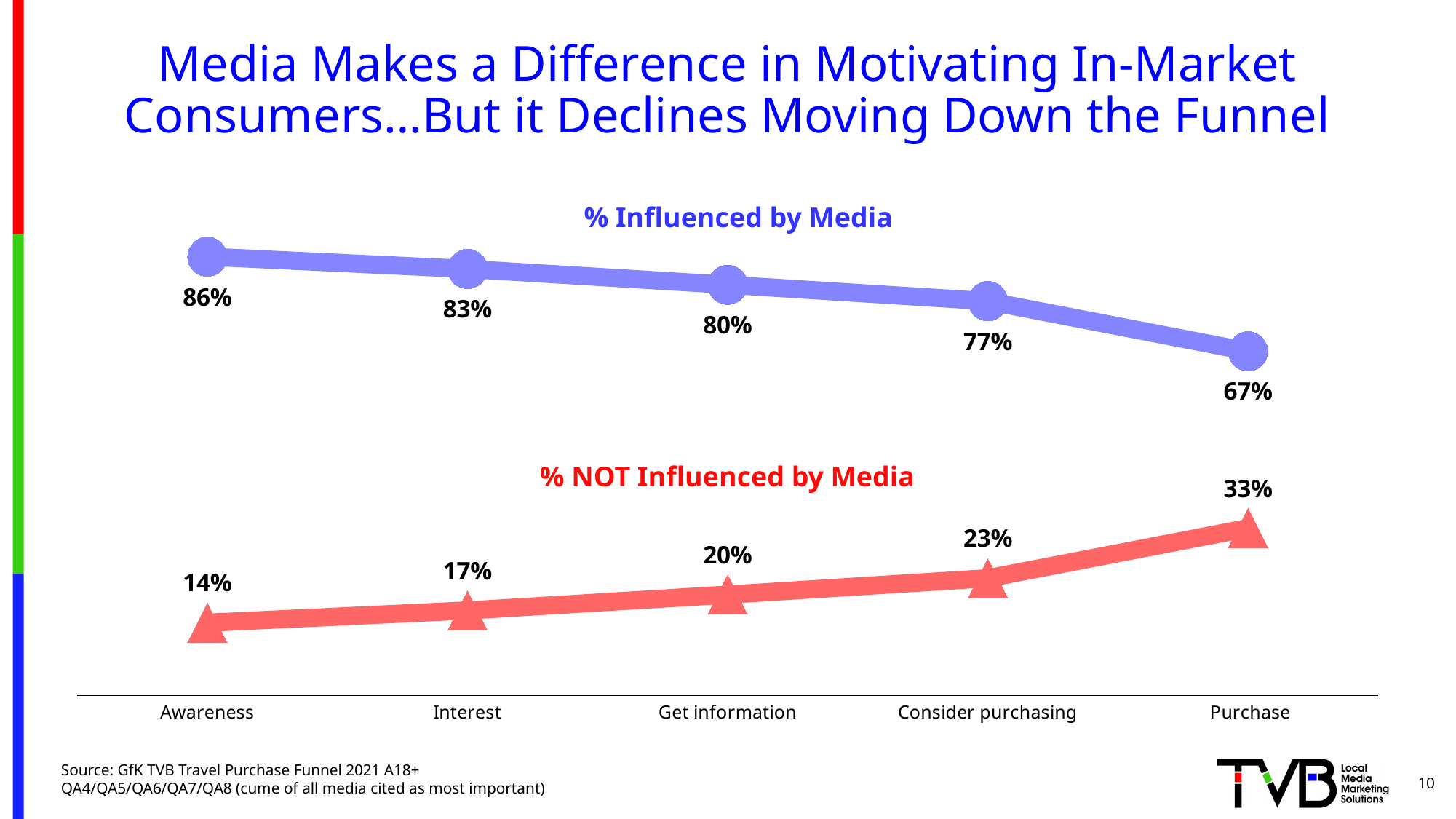
Does '% NOT Influenced by Media' rise or fall moving from Awareness to Purchase? Rise How many data series are plotted on the chart? 2 What type of chart is shown on the slide? Line chart Which is larger: '% Influenced by Media' at Interest or at Get information? Interest What percentage of consumers are influenced by media at the Awareness stage? 86% What is the '% Influenced by Media' value at the Consider purchasing stage? 77% How many funnel stages are shown on the x axis? 5 What is the difference between '% NOT Influenced by Media' at Get information and at Interest? 3 percentage points What is the difference between '% Influenced by Media' at Awareness and at Purchase? 19 percentage points At which funnel stage is '% Influenced by Media' lowest? Purchase At which funnel stage is '% NOT Influenced by Media' highest? Purchase What is the value for '% NOT Influenced by Media' at the Purchase stage? 33%